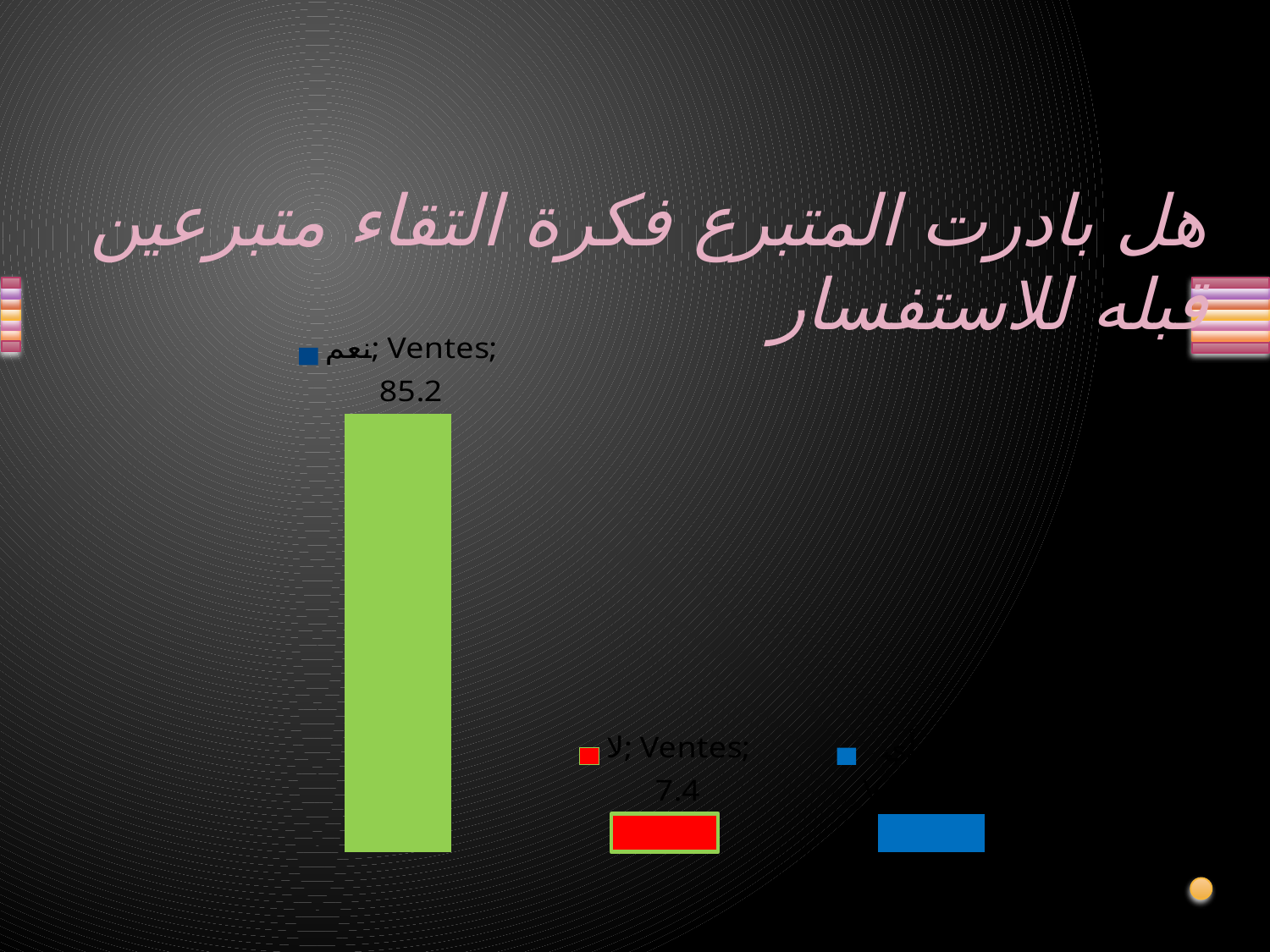
What colour is the bar for لا? red What kind of chart is shown on the slide? bar chart What is the difference between the value for نعم and the value for لا? 77.8 What is the value for نعم? 85.2 Which category has the highest value? نعم How many bars are plotted in the chart? 3 What is the value for لا? 7.4 Which is larger, the value for نعم or the value for لا? نعم What colour is the bar for نعم? green